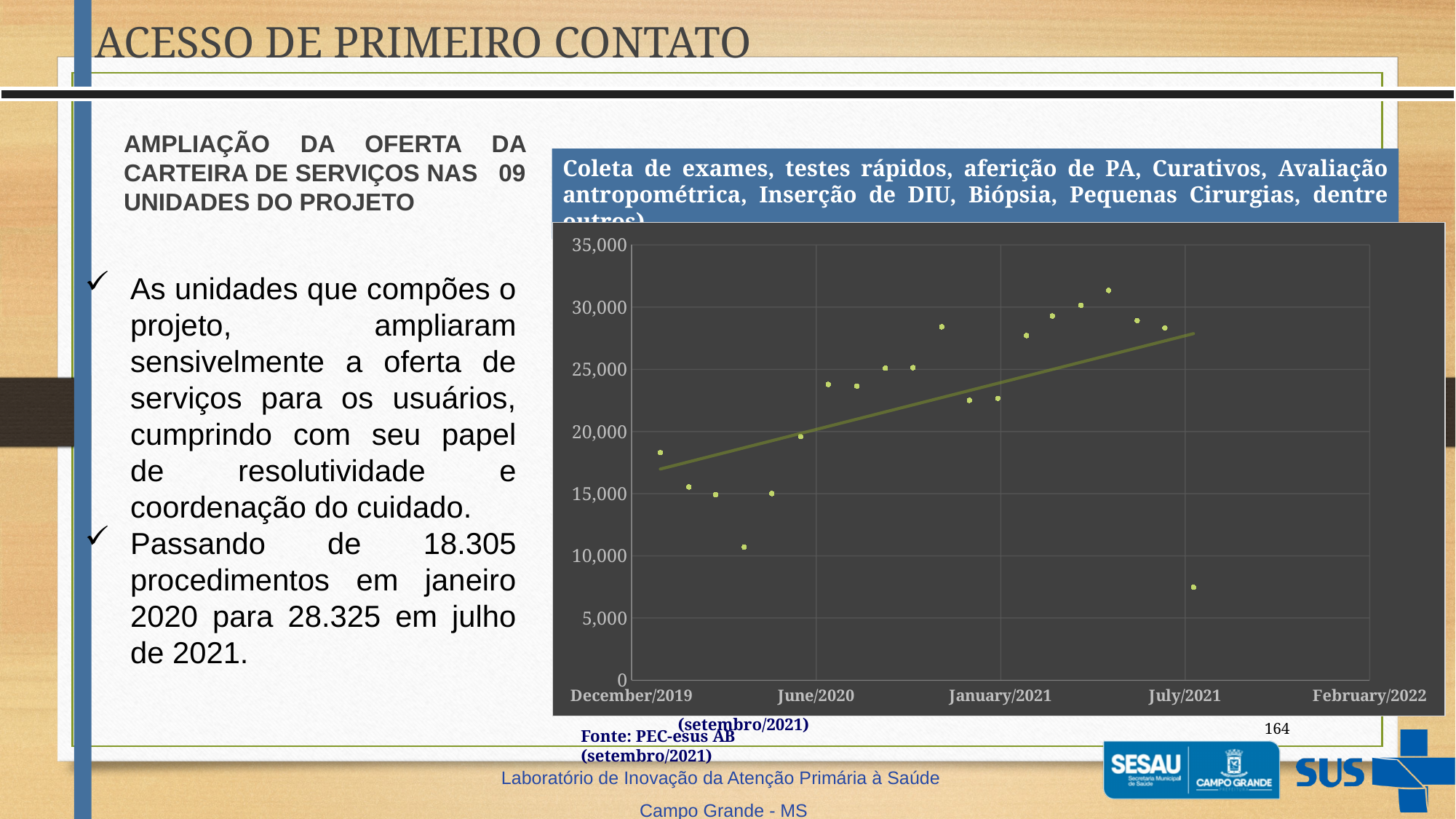
Which is larger: the first plotted point near December/2019 or the last plotted point after July/2021? the first plotted point near December/2019 What is the highest value shown on the y axis? 35,000 Is the lowest plotted point greater or less than 10,000? less Is the highest plotted point greater or less than 30,000? greater What is the last date label shown on the x axis? February/2022 How many points are plotted on the chart? 20 Do the plotted values generally rise or fall from December/2019 to July/2021? rise Is the first plotted point (just after December/2019) greater or less than 15,000? greater What kind of chart is shown on the slide? scatter chart